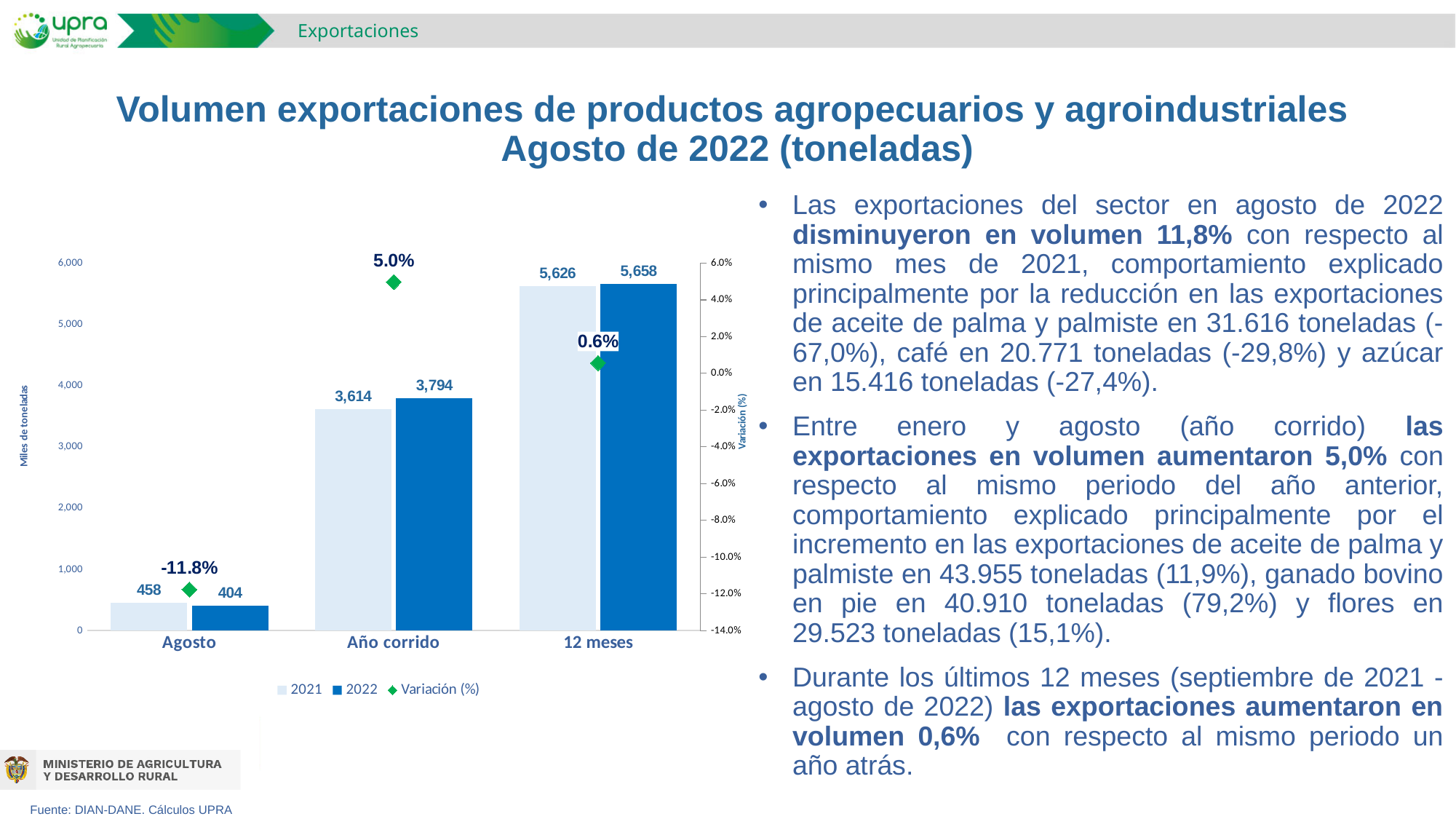
What is the label of the left vertical axis? Miles de toneladas How many categories are shown on the x axis? 3 What is the 2021 value for Agosto? 458 Which category has the lowest 2021 value? Agosto For Agosto, which is larger, the 2021 value or the 2022 value? 2021 What kind of chart is shown on the slide? Bar chart with a line/marker series for variation Which category has the highest 2022 value? 12 meses What is the Variación (%) shown for Agosto? -11.8% What is the 2022 value for Año corrido? 3,794 What is the Variación (%) shown for 12 meses? 0.6% How many series does the legend list? 3 What is the difference between the 2022 and 2021 values for Año corrido? 180